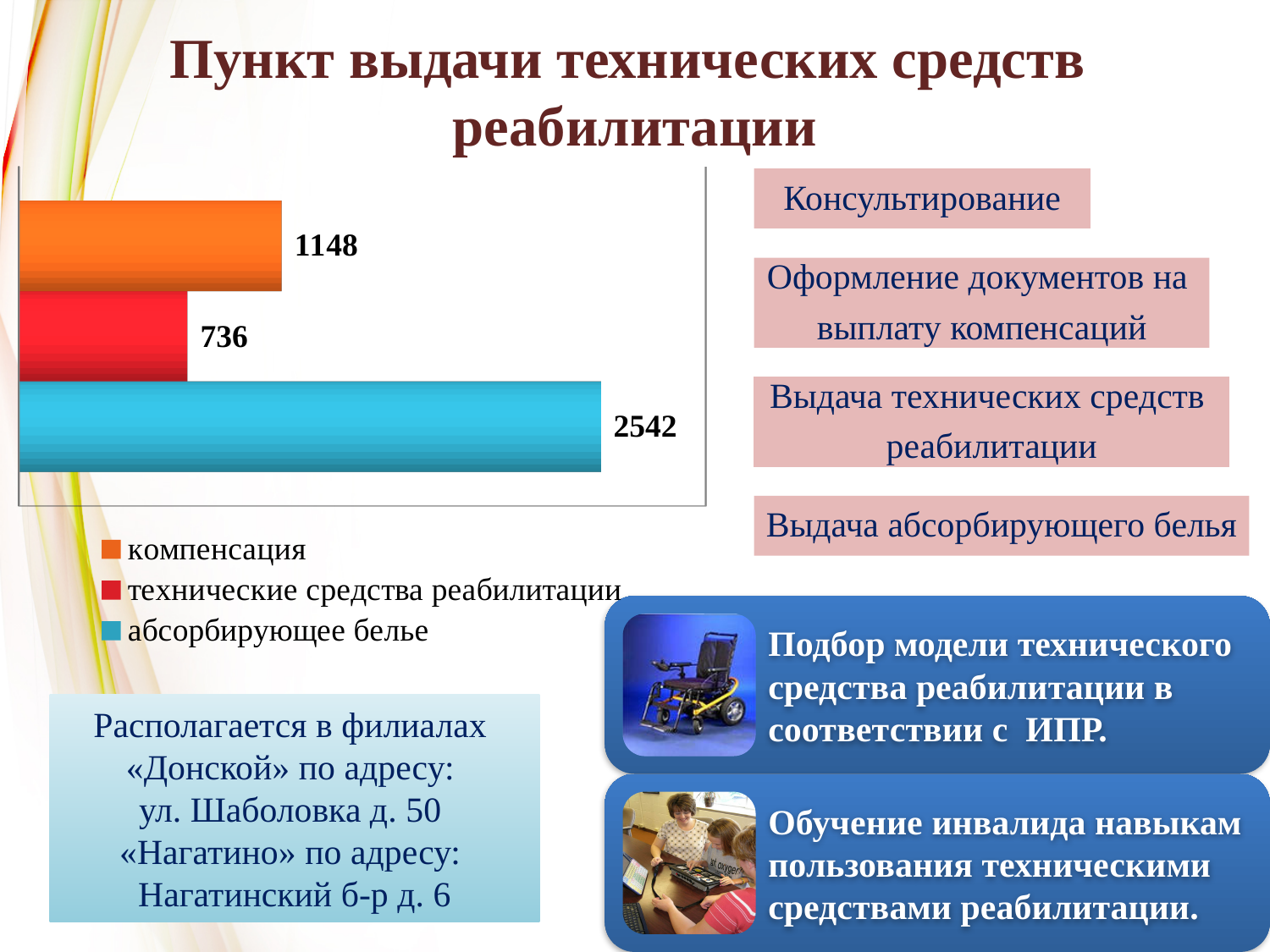
How many entries does the legend list? 3 What is the difference between the values for абсорбирующее белье and компенсация? 1394 What is the value for технические средства реабилитации? 736 Which is larger, the value for компенсация or the value for технические средства реабилитации? компенсация What colour is the bar for абсорбирующее белье? blue What kind of chart is shown on the slide? bar chart Which category has the lowest value? технические средства реабилитации What is the difference between the values for компенсация and технические средства реабилитации? 412 How many bars are shown in the chart? 3 What is the value for абсорбирующее белье? 2542 Which category has the highest value? абсорбирующее белье What is the value for компенсация? 1148